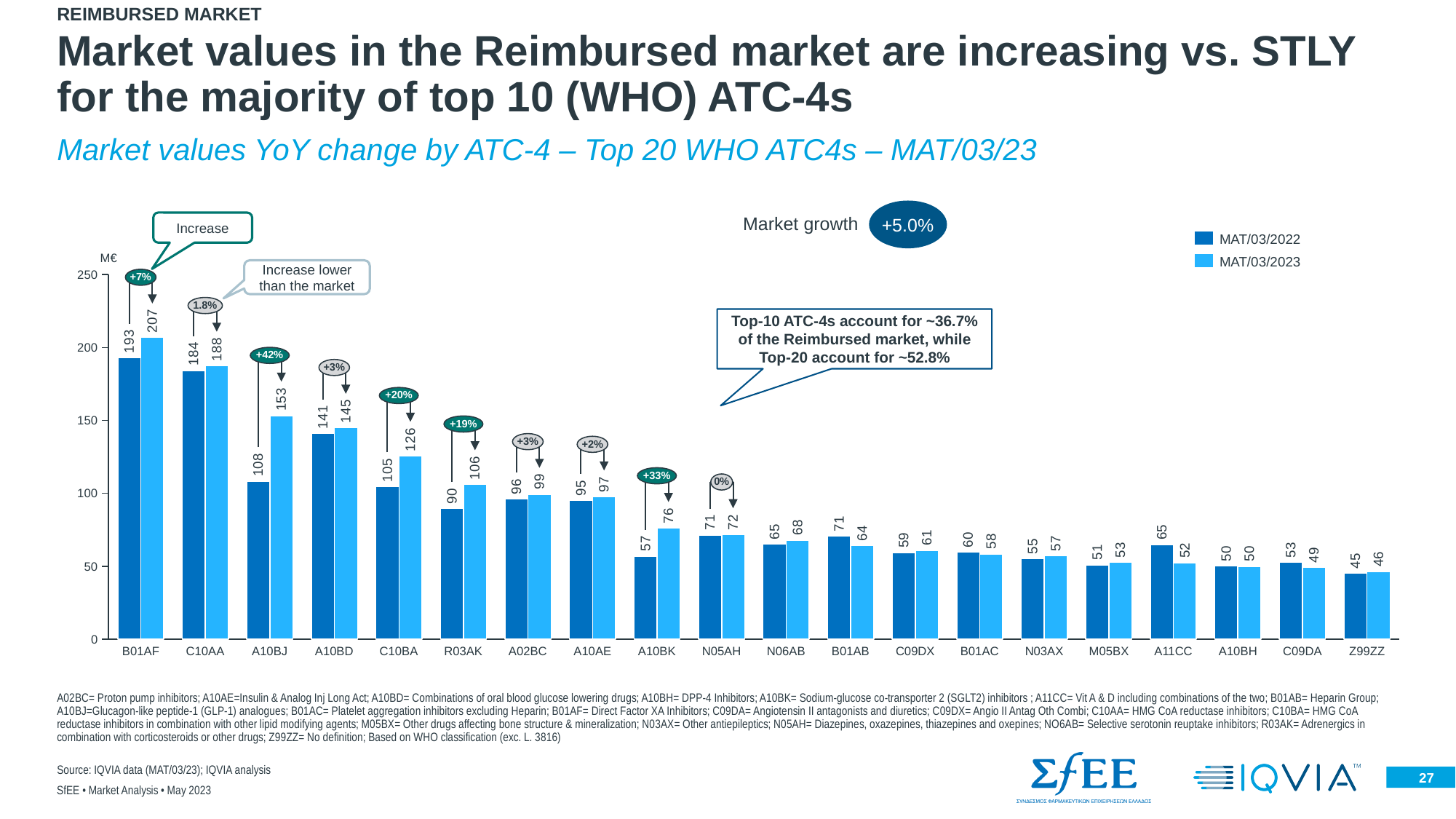
What kind of chart is shown on the slide? Bar chart Which ATC-4 has the highest MAT/03/2023 value? B01AF How many series does the legend list? 2 What is the MAT/03/2023 value for B01AF? 207 What is the percentage change label shown above A10BK? +33% What is the MAT/03/2022 value for A10BJ? 108 Which ATC-4 has the lowest MAT/03/2022 value? Z99ZZ Which is larger for A11CC: the MAT/03/2022 value or the MAT/03/2023 value? MAT/03/2022 What is the difference between the MAT/03/2023 and MAT/03/2022 values for A10BJ? 45 What overall market growth figure is shown on the slide? +5.0% How many ATC-4 categories are shown on the x axis? 20 What unit is shown on the y axis of the chart? M€